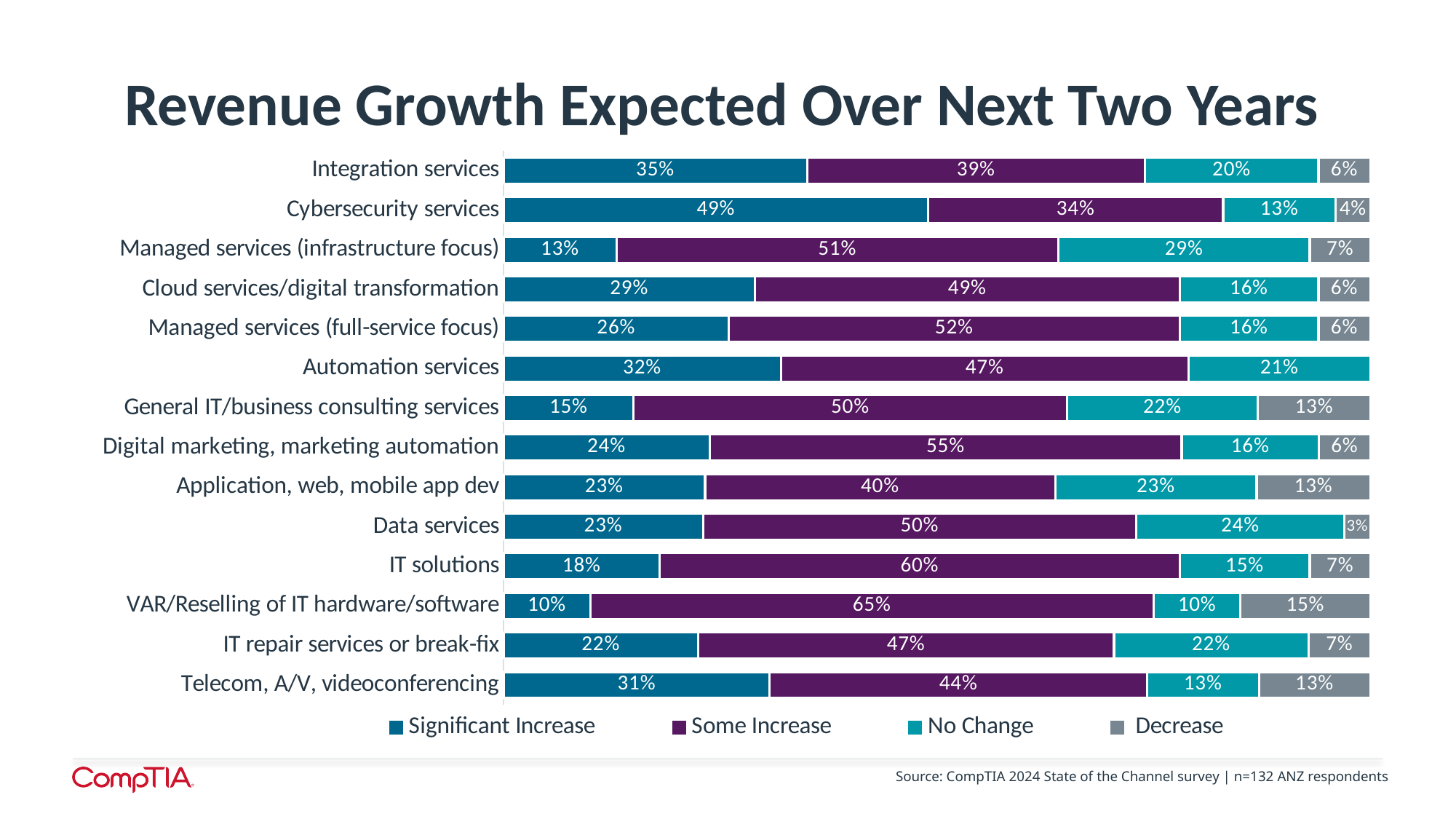
Which category has the highest Some Increase value? VAR/Reselling of IT hardware/software How many service categories are shown in the chart? 14 What percentage of respondents expect a Significant Increase in revenue for Cybersecurity services? 49% Which category has the lowest Significant Increase value? VAR/Reselling of IT hardware/software What is the No Change value for Managed services (infrastructure focus)? 29% What type of chart is shown on the slide? Stacked bar chart What is the difference between the Significant Increase values for Cybersecurity services and Integration services? 14 percentage points What is the Some Increase value for VAR/Reselling of IT hardware/software? 65% How many series does the legend list? 4 Which has a larger Some Increase value, IT solutions or Telecom, A/V, videoconferencing? IT solutions Which category has the highest Significant Increase value? Cybersecurity services What is the Decrease value for Data services? 3%